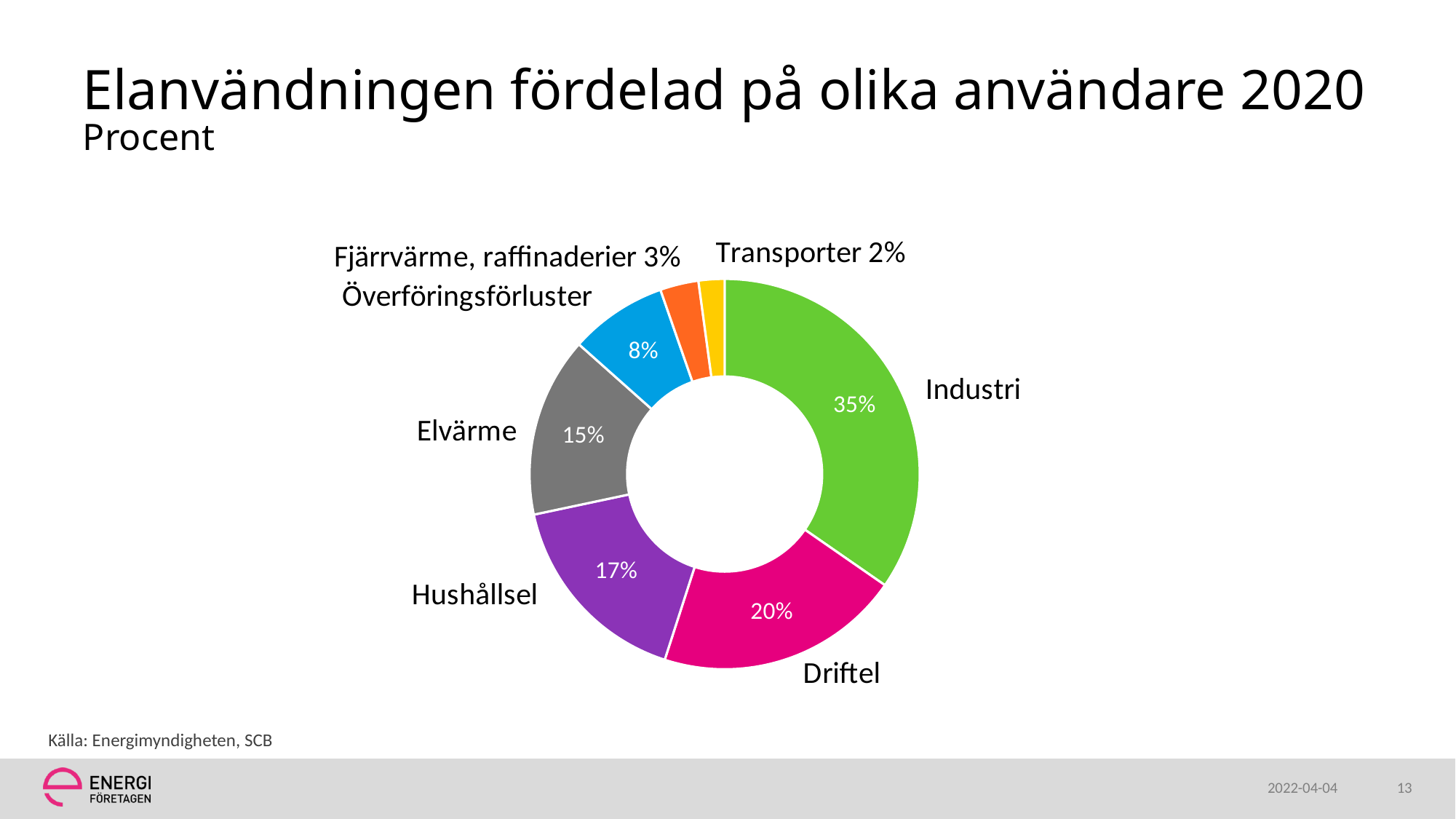
Which category has the smallest share of the chart? Transporter What percentage is shown for Elvärme? 15% Which is larger, the share for Hushållsel or the share for Elvärme? Hushållsel Which category has the largest share of the chart? Industri How many categories are shown in the chart? 7 What type of chart is shown on the slide? Pie chart (donut) What percentage is shown for Hushållsel? 17% What share of electricity use does Industri account for? 35% What percentage is shown for Överföringsförluster? 8% What is the difference in percentage points between Industri and Driftel? 15 What percentage is shown for Transporter? 2% What percentage is shown for Driftel? 20%